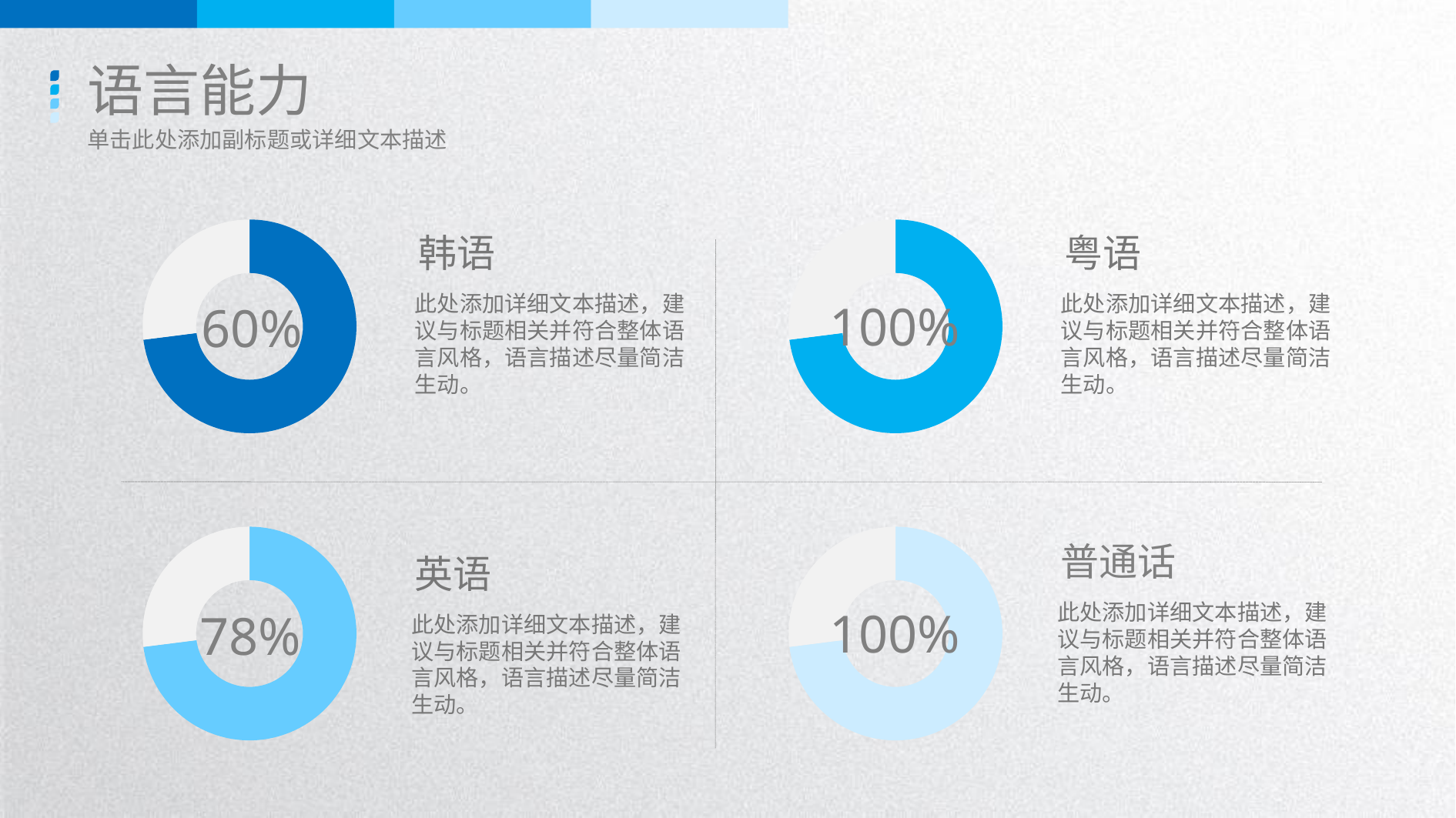
What percentage is shown in the 英语 donut chart? 78% What percentage is shown in the 普通话 donut chart? 100% Which is larger, the percentage for 英语 or the percentage for 韩语? 英语 What is the difference between the 粤语 percentage and the 英语 percentage? 22% What is the difference between the 英语 percentage and the 韩语 percentage? 18% Which two languages share the highest percentage shown on the slide? 粤语 and 普通话 How many donut charts are shown on the slide? 4 What kind of chart is used to show each language's percentage? Donut (pie) chart Which language has the lowest percentage among the four donut charts? 韩语 What percentage is shown in the 韩语 donut chart? 60% What percentage is shown in the 粤语 donut chart? 100% What is the title of the slide containing the four donut charts? 语言能力